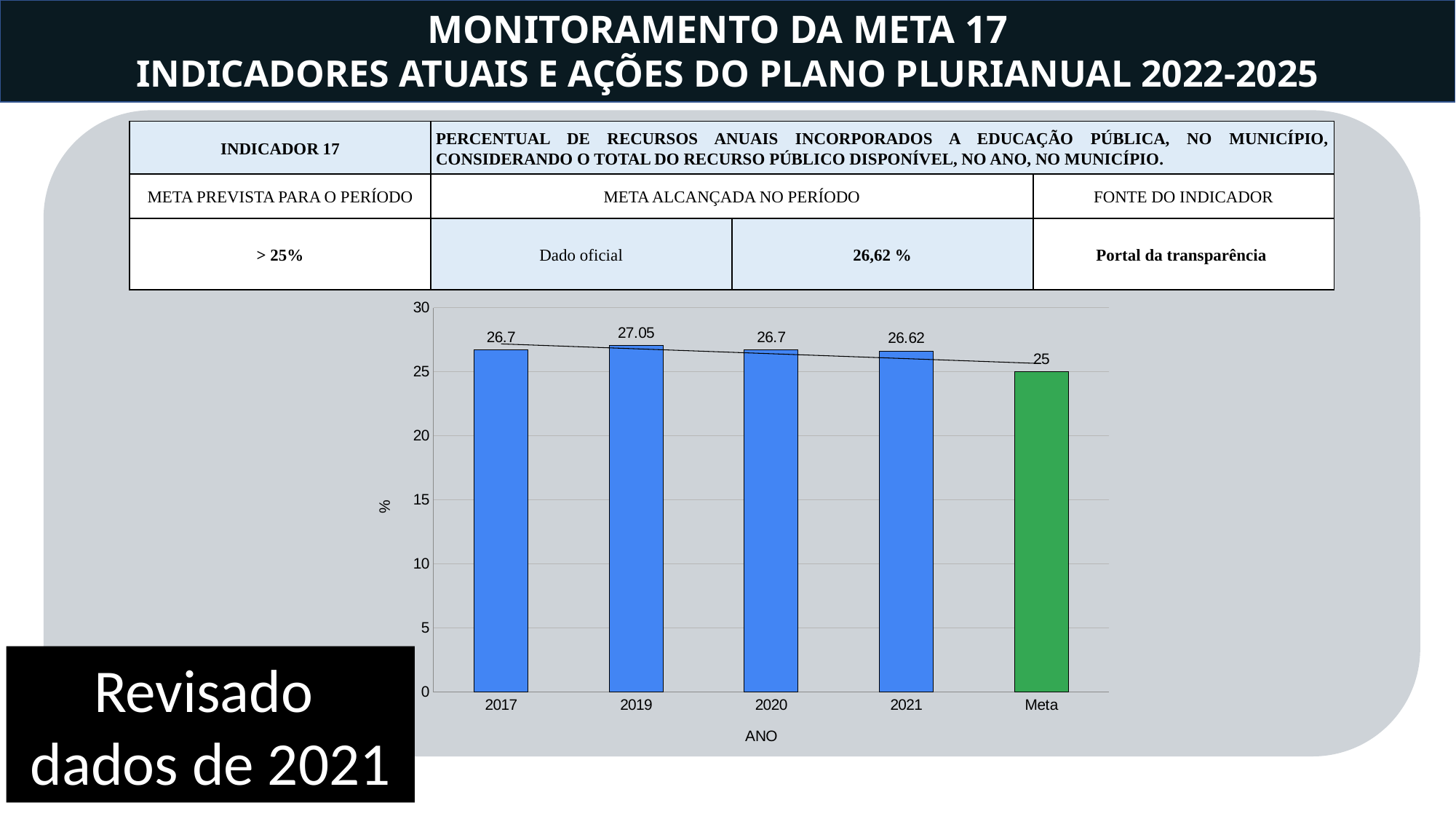
Which is larger, the value for 2019 or the value for 2021? 2019 Is the value for 2020 greater or less than 25? greater What is the value of the Meta bar in the chart? 25 What is the value for 2021 in the chart? 26.62 Which category has the highest value in the chart? 2019 How many bars are shown in the chart? 5 What is the difference between the 2017 value and the 2021 value? 0.08 Which category has the lowest value in the chart? Meta What kind of chart is shown on the slide? bar chart What is the label of the x axis of the chart? ANO What is the difference between the 2019 value and the Meta value? 2.05 What is the value for 2019 in the chart? 27.05